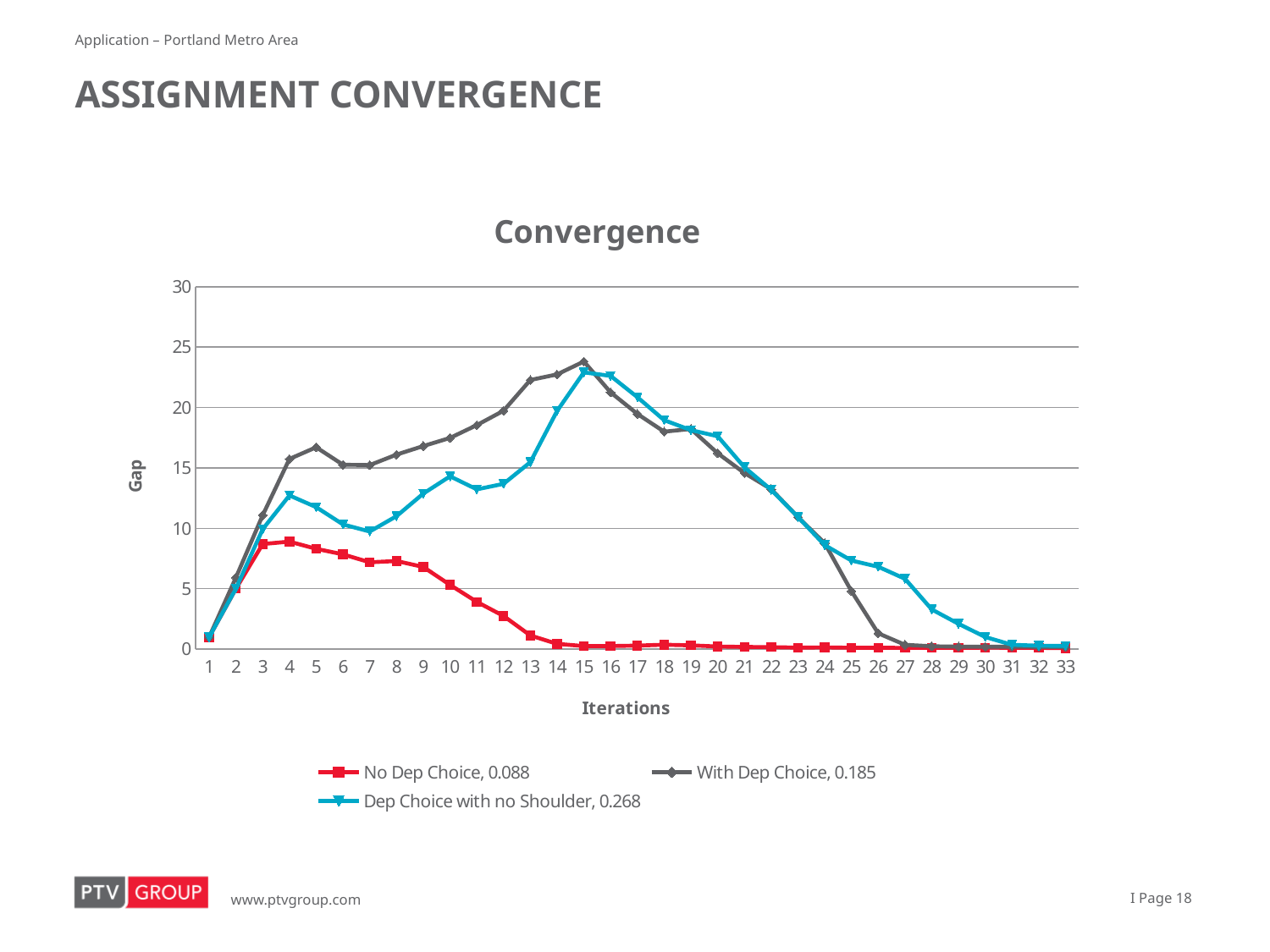
Is the value for Dep Choice with no Shoulder at iteration 4 greater or less than 10? greater What is the label of the y axis of the chart? Gap How many series does the legend of the Convergence chart list? 3 Is the value for No Dep Choice at iteration 15 greater or less than 5? less How many iterations are shown along the x axis of the Convergence chart? 33 Is the value for With Dep Choice at iteration 15 greater or less than 20? greater At which iteration does the With Dep Choice series reach its highest value? 15 What kind of chart is shown on the slide? Line chart Does the No Dep Choice series rise or fall between iteration 4 and iteration 14? fall At iteration 10, which series has the larger value: With Dep Choice or No Dep Choice? With Dep Choice What is the title of the chart? Convergence